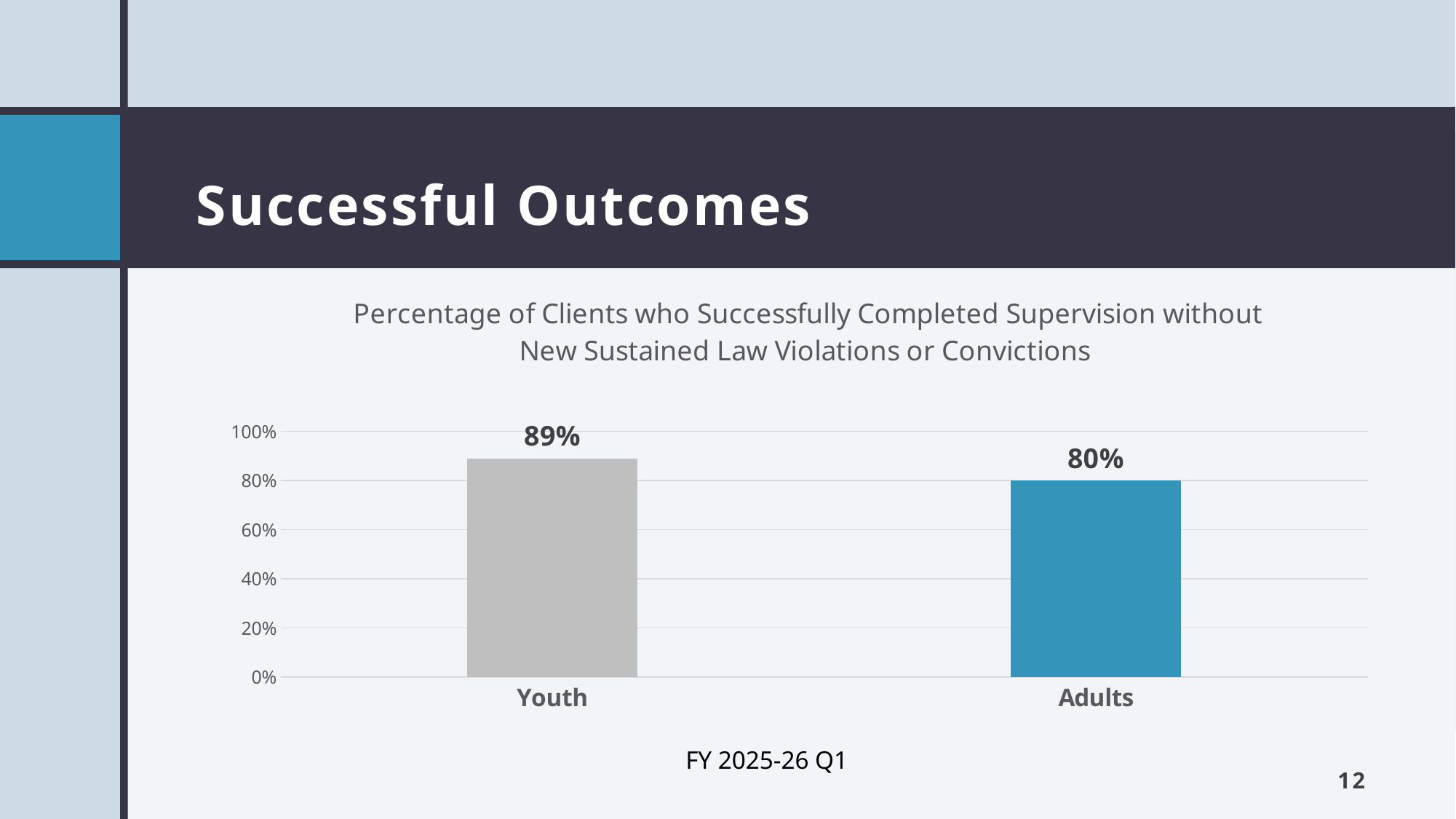
What percentage of Adults successfully completed supervision without new sustained law violations or convictions? 80% Which category has the higher percentage of successful completions? Youth What percentage of Youth clients successfully completed supervision without new sustained law violations or convictions? 89% How many categories are shown on the chart? 2 What is the difference in percentage points between the Youth and Adults values? 9% Which category has the lower percentage of successful completions? Adults What fiscal period is shown below the chart? FY 2025-26 Q1 Is the value for Youth greater or less than 100%? less What type of chart is shown on the slide? bar chart What is the title of the chart? Percentage of Clients who Successfully Completed Supervision without New Sustained Law Violations or Convictions Is the value for Adults greater or less than 60%? greater Is the value for Youth larger or smaller than the value for Adults? larger